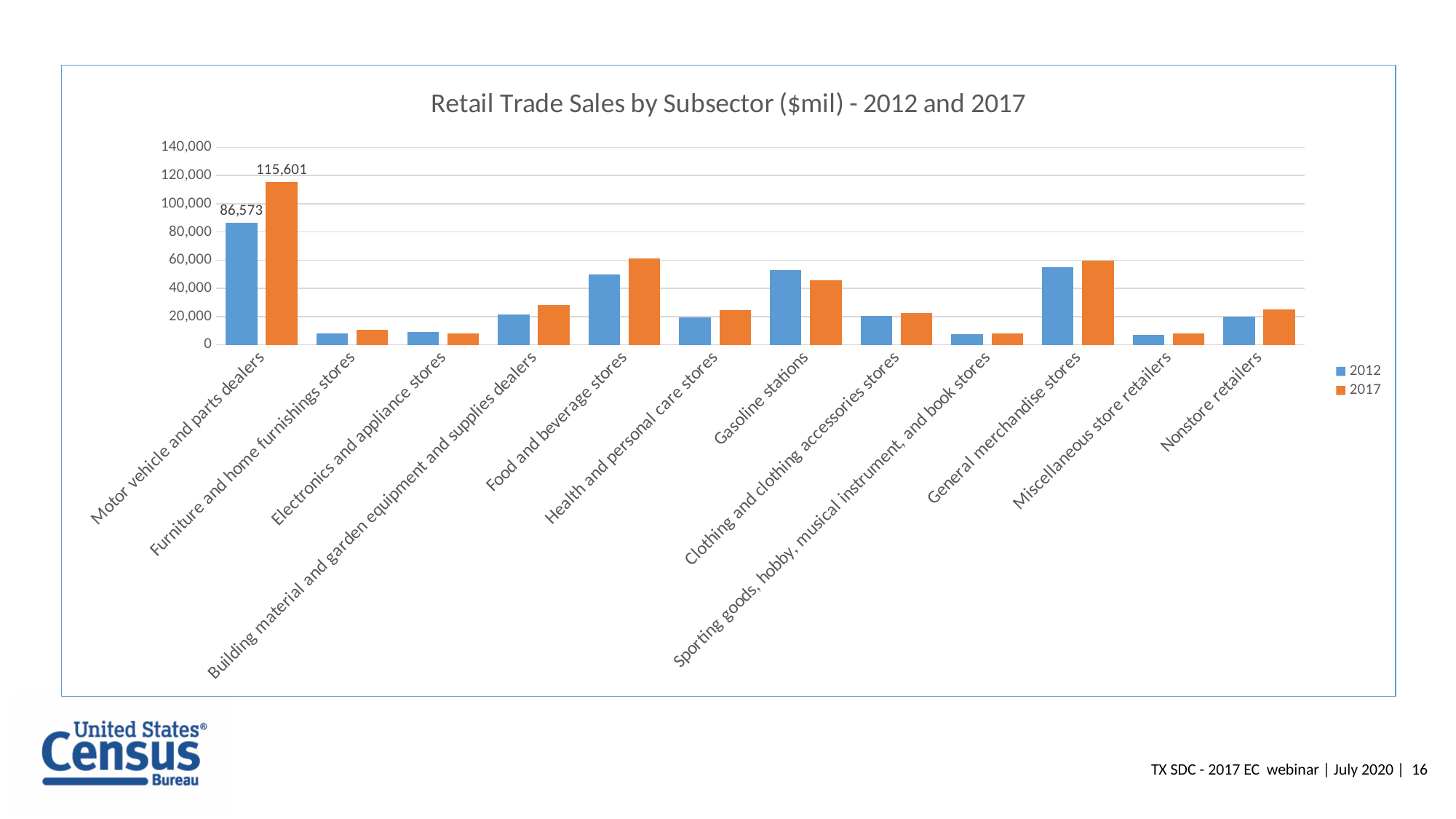
How many series does the legend list? 2 For Gasoline stations, which year has the larger value, 2012 or 2017? 2012 Is the 2012 value for Gasoline stations greater or less than 40,000? greater What type of chart is shown on the slide? Bar chart What is the difference between the 2017 and 2012 values for Motor vehicle and parts dealers? 29,028 Which subsector has the highest sales in 2017? Motor vehicle and parts dealers Which subsector has the highest sales in 2012? Motor vehicle and parts dealers What is the 2017 value for Motor vehicle and parts dealers? 115,601 Is the 2017 value for Building material and garden equipment and supplies dealers greater or less than 20,000? greater How many subsectors are shown on the x axis? 12 What is the 2012 value for Motor vehicle and parts dealers? 86,573 Is the 2012 value for Sporting goods, hobby, musical instrument, and book stores greater or less than 20,000? less